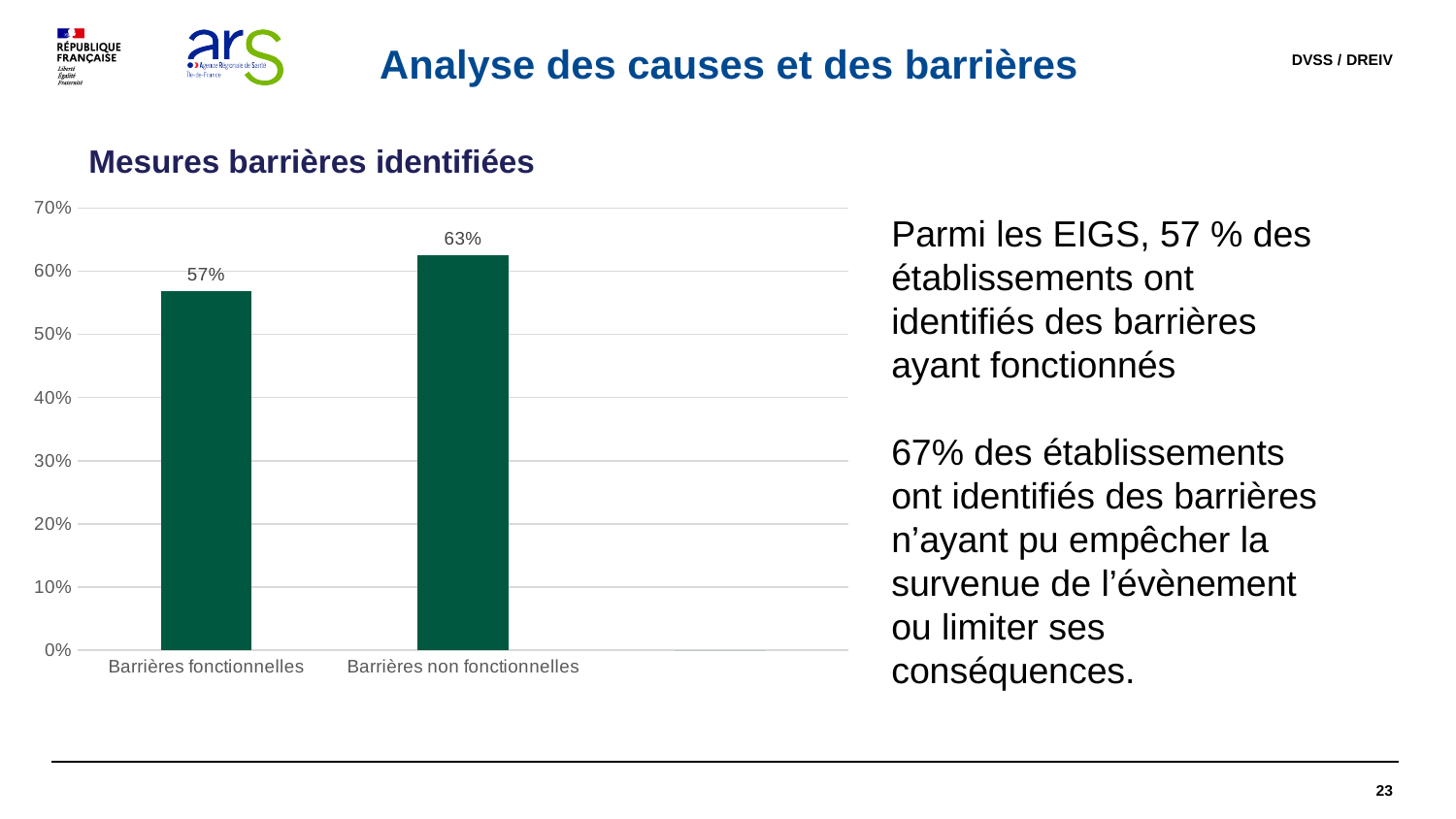
What kind of chart is shown on the slide? Bar chart Which category has the highest value? Barrières non fonctionnelles Is the value for Barrières fonctionnelles greater or less than 60%? less What is the value for Barrières non fonctionnelles? 63% Is the value for Barrières non fonctionnelles greater or less than 60%? greater What is the title of the chart? Mesures barrières identifiées What is the difference between the values for Barrières non fonctionnelles and Barrières fonctionnelles? 6% What is the highest value shown on the y axis of the chart? 70% How many categories are shown on the x axis of the chart? 2 Which category has the lowest value? Barrières fonctionnelles Which is larger, the value for Barrières fonctionnelles or the value for Barrières non fonctionnelles? Barrières non fonctionnelles What is the value for Barrières fonctionnelles? 57%